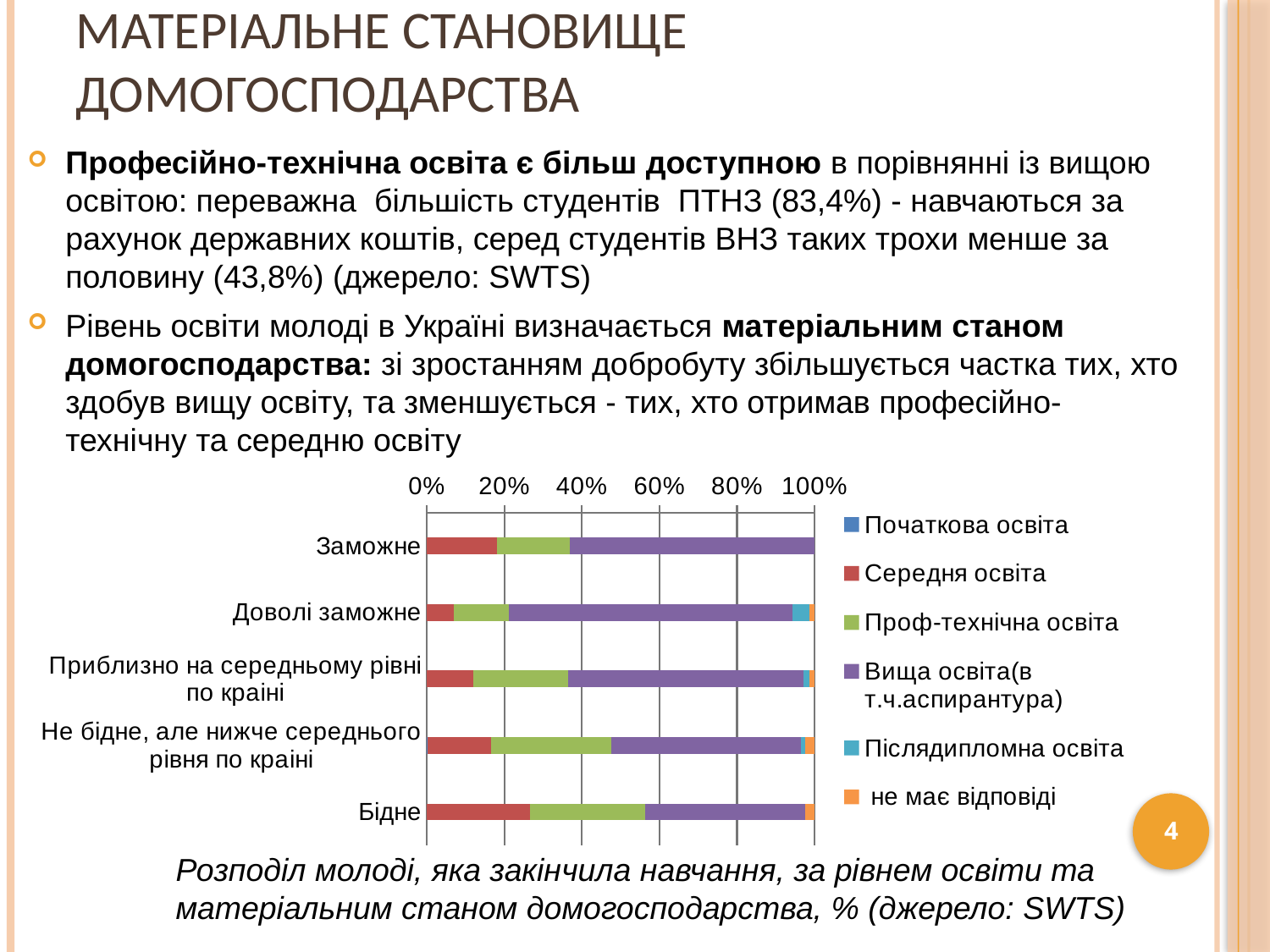
Is the value of Проф-технічна освіта for Бідне greater or less than 20%? greater Is the value of Середня освіта for Доволі заможне greater or less than 20%? less Is the value of Середня освіта for Бідне greater or less than 20%? greater How many household wealth categories are plotted on the chart? 5 How many series does the chart legend list? 6 Which has the larger share of Вища освіта(в т.ч.аспирантура): Заможне or Бідне? Заможне What colour represents Вища освіта(в т.ч.аспирантура) in the chart legend? Purple Which has the larger share of Середня освіта: Бідне or Доволі заможне? Бідне Which has the larger share of Проф-технічна освіта: Не бідне, але нижче середнього рівня по країні or Заможне? Не бідне, але нижче середнього рівня по країні What kind of chart is shown on the slide? Stacked bar chart Which household category has the largest share of Середня освіта? Бідне